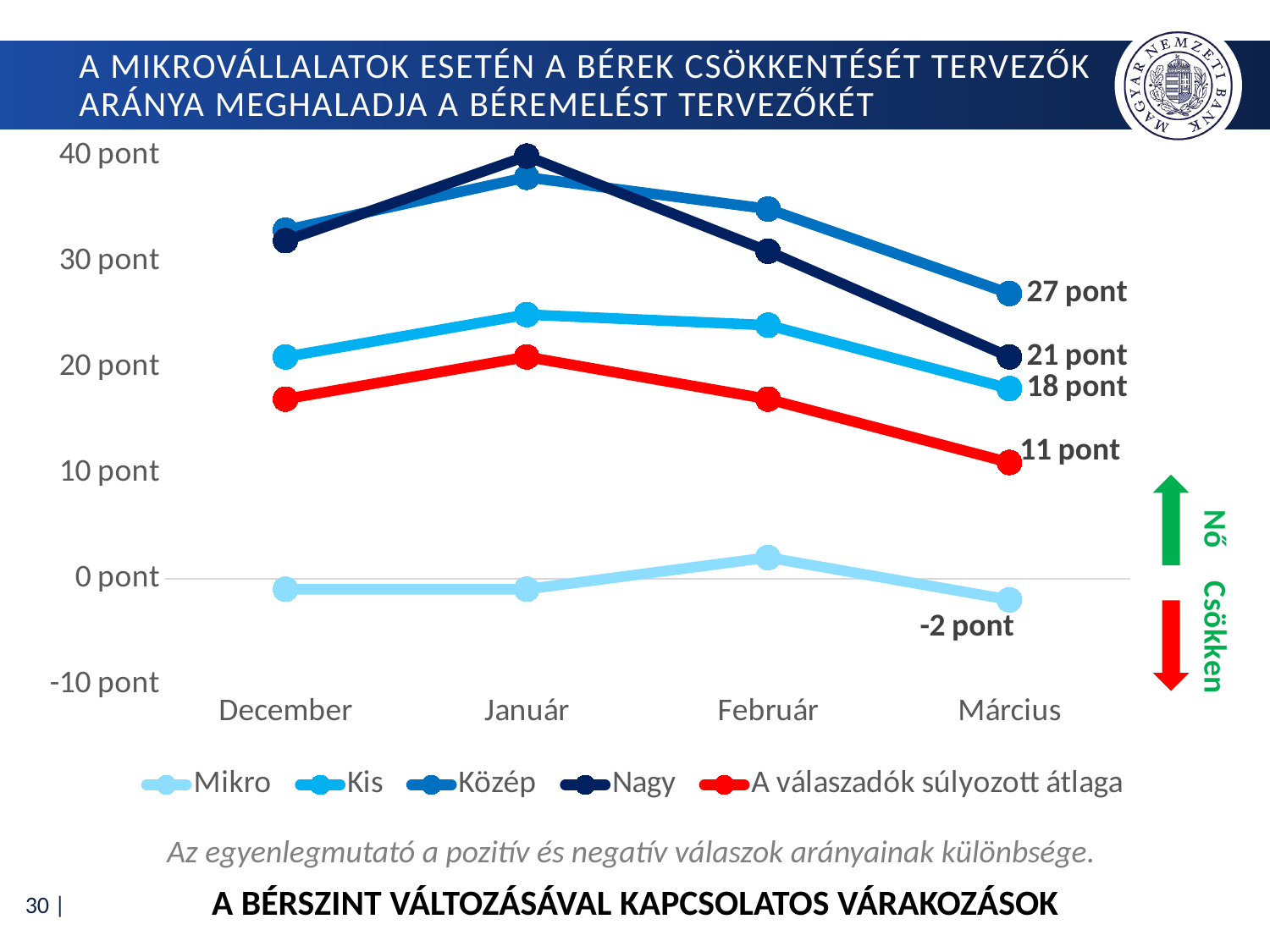
What is the value for Közép in Március? 27 pont What is the value for Mikro in Március? -2 pont What is the difference between the Közép and Nagy values in Március? 6 pont What kind of chart is shown on the slide? line chart Is the value for Nagy in Január greater or less than 30 pont? greater What is the value for A válaszadók súlyozott átlaga in Március? 11 pont What is the value for Nagy in Március? 21 pont Which series has the highest value in Március? Közép Does the value for A válaszadók súlyozott átlaga rise or fall from Január to Március? fall How many series does the legend list? 5 In Március, which is larger: the value for Nagy or the value for Kis? Nagy Which series has the lowest value in Március? Mikro